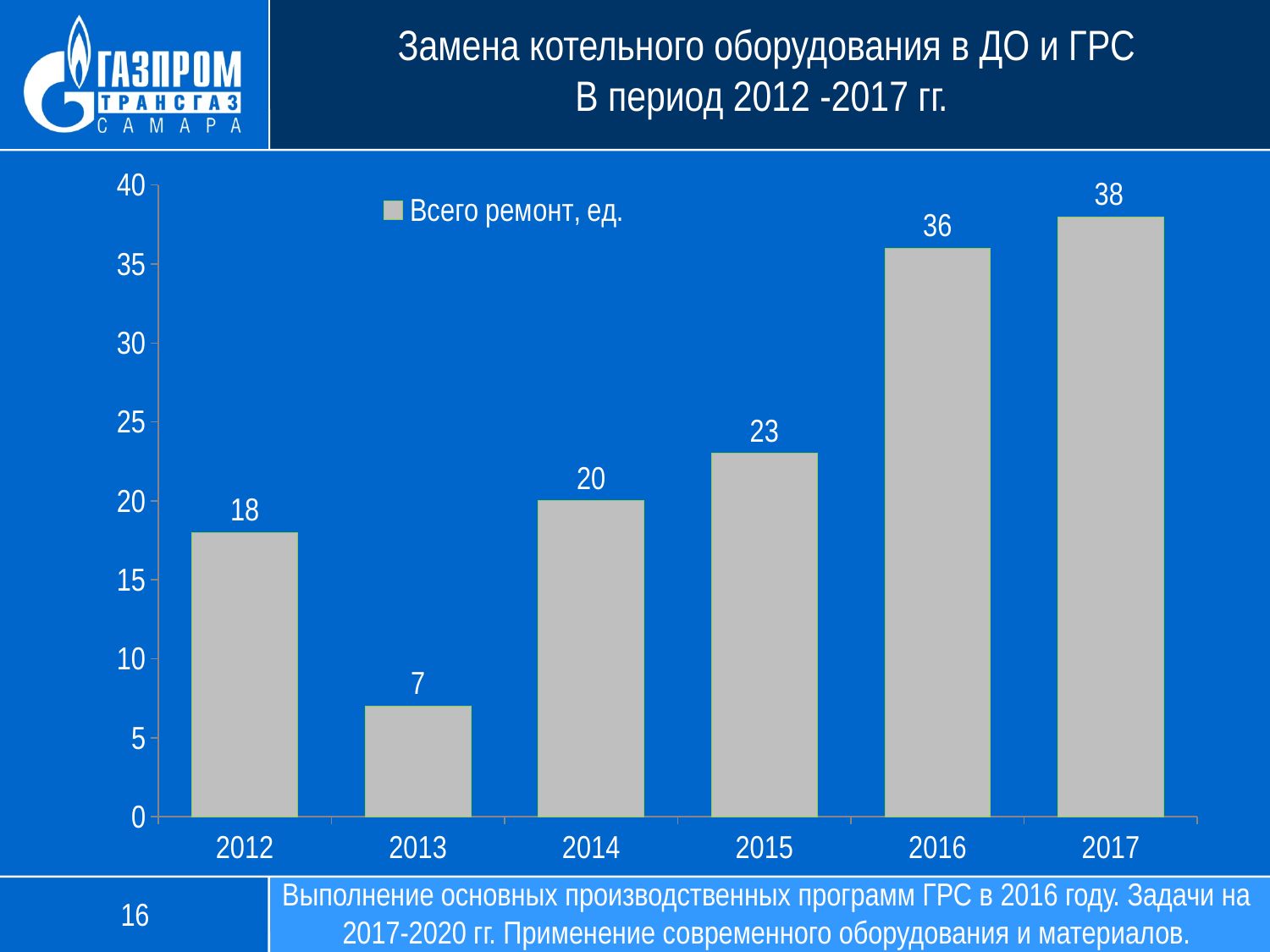
Which year has the lowest value? 2013 Which is larger, the value for 2014 or the value for 2015? 2015 What is the value for 2017? 38 Which year has the highest value? 2017 What kind of chart is shown on the slide? bar chart Is the value for 2016 greater or less than 30? greater What is the difference between the values for 2017 and 2012? 20 What is the value for 2015? 23 What is the legend entry for the series shown? Всего ремонт, ед. What is the value for 2012? 18 What is the difference between the values for 2016 and 2013? 29 How many years are shown on the x axis? 6